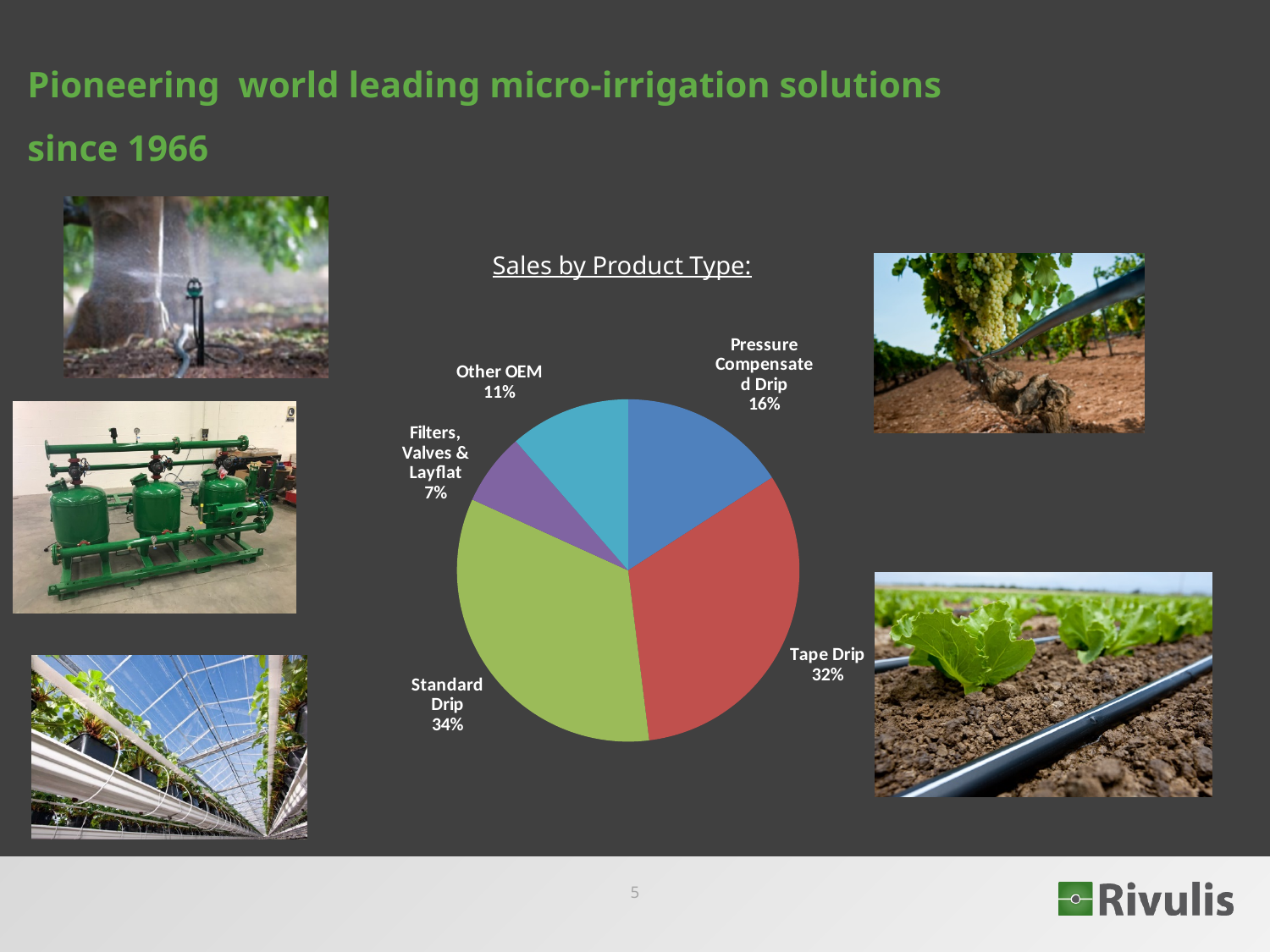
Which has a larger share of sales, Other OEM or Filters, Valves & Layflat? Other OEM What type of chart is used to show Sales by Product Type? Pie chart What is the difference in percentage points between Standard Drip and Tape Drip? 2 Which product type has the largest share of sales? Standard Drip What share of sales is Other OEM? 11% How many product types are shown in the pie chart? 5 What percentage of sales is Pressure Compensated Drip? 16% What share of sales does Tape Drip account for in the Sales by Product Type pie chart? 32% What percentage of sales comes from Filters, Valves & Layflat? 7% Which product type has the smallest share of sales? Filters, Valves & Layflat What is the title of the chart on the slide? Sales by Product Type: What is the difference in percentage points between Pressure Compensated Drip and Other OEM? 5